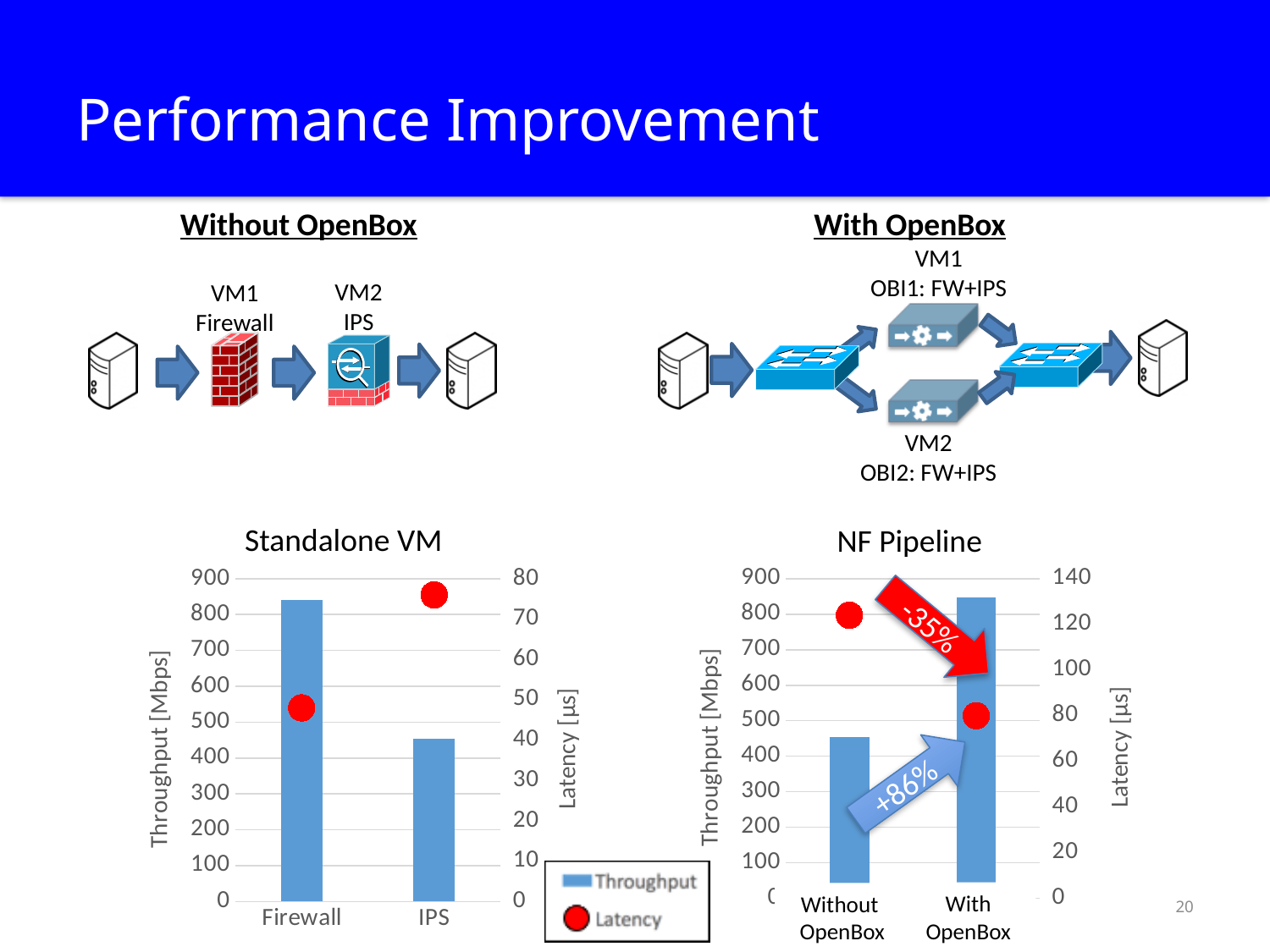
In the Standalone VM chart, which category has the higher throughput? Firewall In the NF Pipeline chart, is the latency for Without OpenBox greater or less than 100? greater How many series does the legend list for the charts? 2 In the Standalone VM chart, which category has the lower latency? Firewall What kind of chart is the Standalone VM chart? combination chart with bars for throughput and dot markers for latency In the NF Pipeline chart, which category has the higher throughput? With OpenBox How many categories are shown on the x axis of the Standalone VM chart? 2 What percentage change in throughput is annotated on the NF Pipeline chart? +86% In the Standalone VM chart, is the throughput for IPS greater or less than 500? less In the NF Pipeline chart, is the throughput for With OpenBox greater or less than 800? greater In the NF Pipeline chart, does latency rise or fall from Without OpenBox to With OpenBox? fall